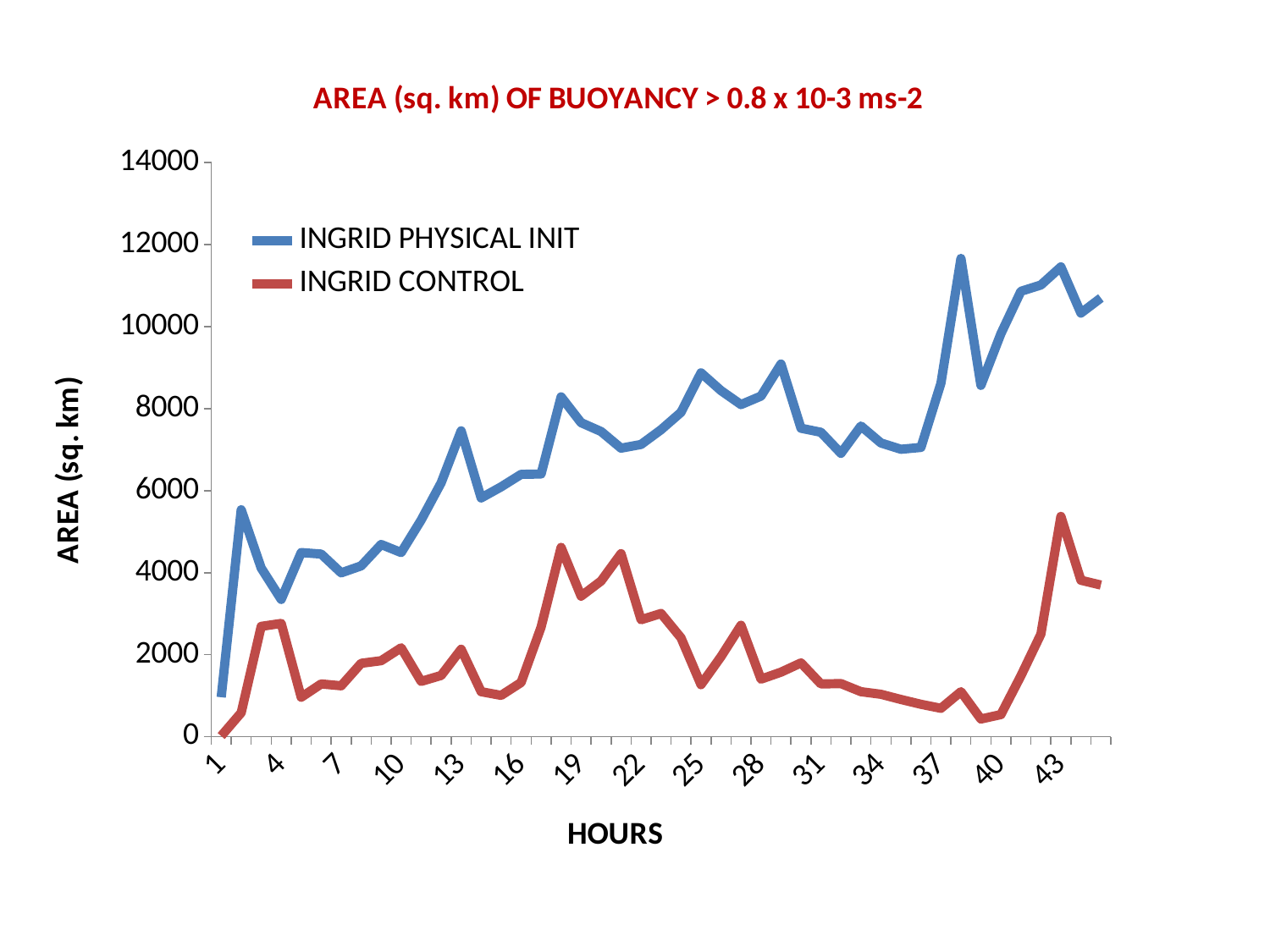
Does the INGRID PHYSICAL INIT series generally rise or fall from hour 1 to hour 43? rise Is the INGRID PHYSICAL INIT value at hour 13 greater or less than 6000? greater At hour 25, which series has the higher value, INGRID PHYSICAL INIT or INGRID CONTROL? INGRID PHYSICAL INIT Is the INGRID PHYSICAL INIT value at hour 38 greater or less than 10000? greater Is the INGRID CONTROL value at hour 43 greater or less than 4000? greater Which series stays higher across the whole range of hours? INGRID PHYSICAL INIT What are the two series named in the legend? INGRID PHYSICAL INIT and INGRID CONTROL What is the label of the x axis? HOURS What kind of chart is shown on the slide? line chart How many series does the legend list? 2